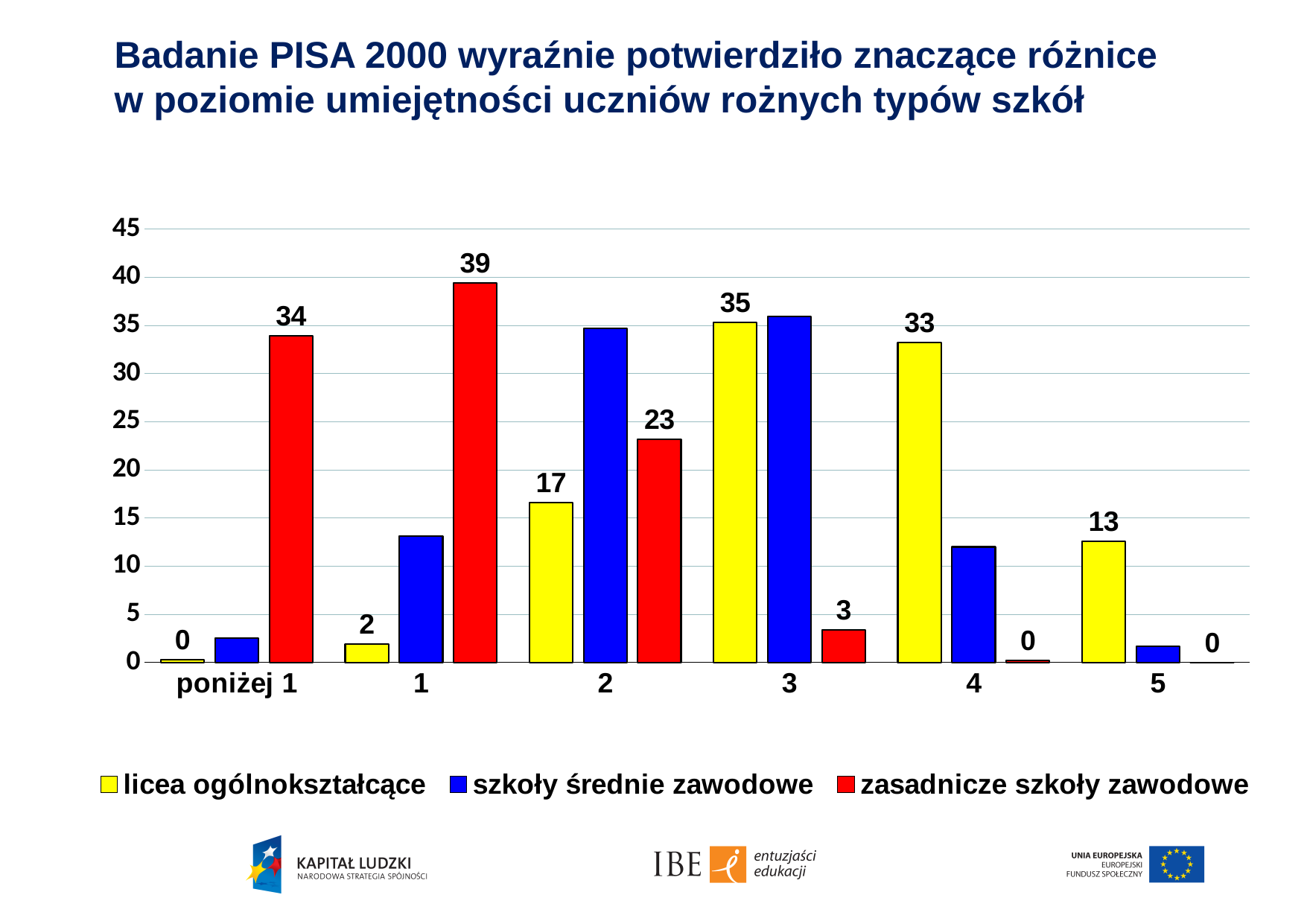
At which level is the value for zasadnicze szkoły zawodowe highest? 1 What is the value for zasadnicze szkoły zawodowe at level 1? 39 Is the value for szkoły średnie zawodowe at level 1 greater or less than 10? greater What type of chart is shown on the slide? bar chart What is the value for licea ogólnokształcące at level 3? 35 How many categories are shown on the x axis? 6 Do the values for zasadnicze szkoły zawodowe rise or fall from level 1 to level 5? fall What is the difference between the zasadnicze szkoły zawodowe value at level 1 and at level 2? 16 Which is larger at level 2: licea ogólnokształcące or zasadnicze szkoły zawodowe? zasadnicze szkoły zawodowe What is the value for licea ogólnokształcące at level 5? 13 At which level is the value for licea ogólnokształcące highest? 3 How many series does the legend list? 3